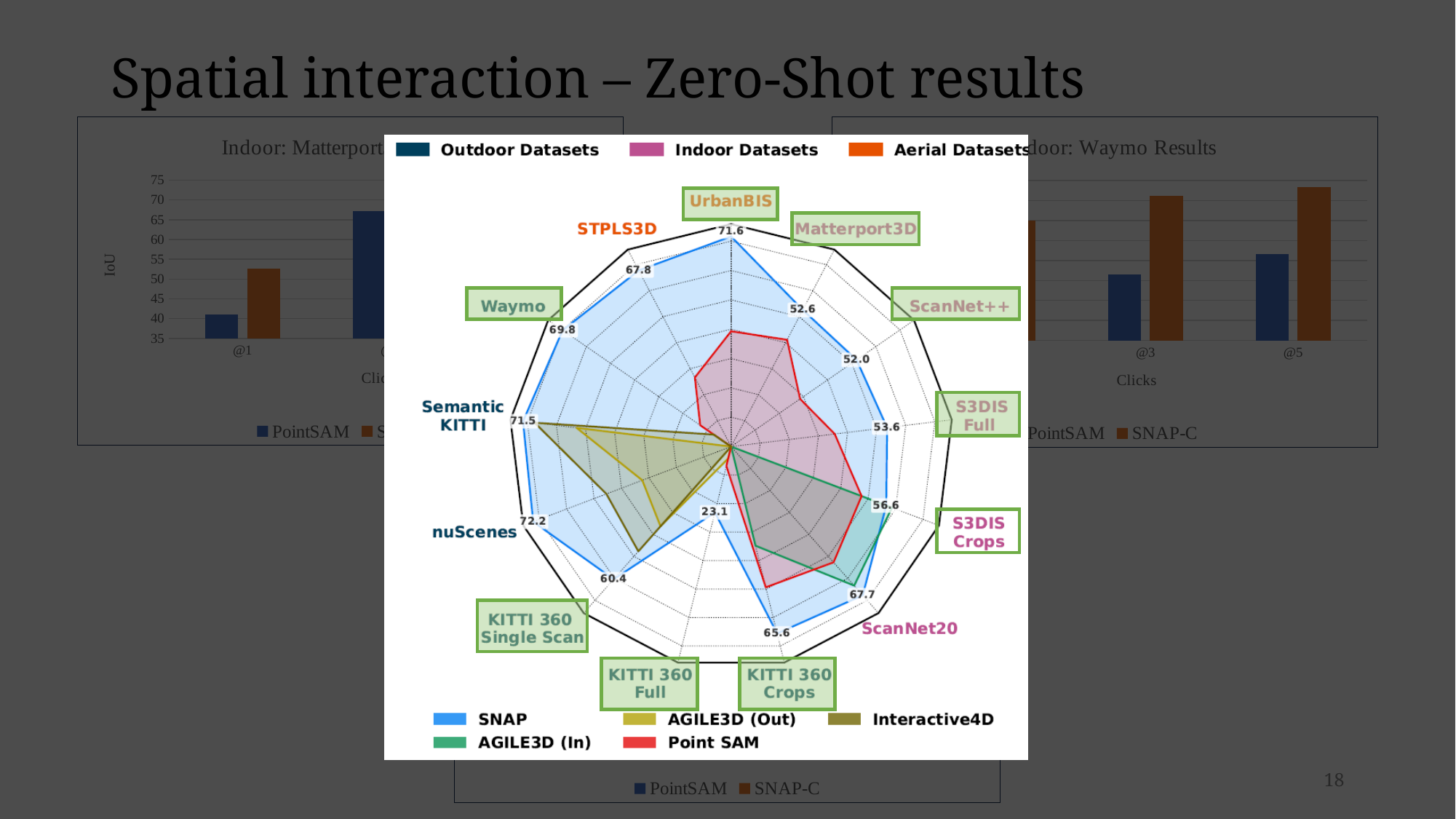
In the bar chart on the right (Waymo Results), which series has the taller bar at @3, PointSAM or SNAP-C? SNAP-C In the radar chart, which dataset has the highest labelled SNAP value? nuScenes In the radar chart, which colour represents Point SAM? Red In the radar chart, which is larger, the SNAP value for Semantic KITTI or for S3DIS Full? Semantic KITTI In the radar chart, what is the SNAP value for Matterport3D? 52.6 In the radar chart, what is the SNAP value for S3DIS Crops? 56.6 How many methods does the legend at the bottom of the radar chart list? 5 In the radar chart, what is the SNAP value for UrbanBIS? 71.6 In the radar chart, what is the SNAP value for Waymo? 69.8 In the radar chart, what is the difference between the SNAP values for STPLS3D and ScanNet++? 15.8 In the bar chart on the left (Indoor: Matterport), is the SNAP-C value at @1 greater or less than 50? greater In the radar chart, what is the SNAP value for nuScenes? 72.2